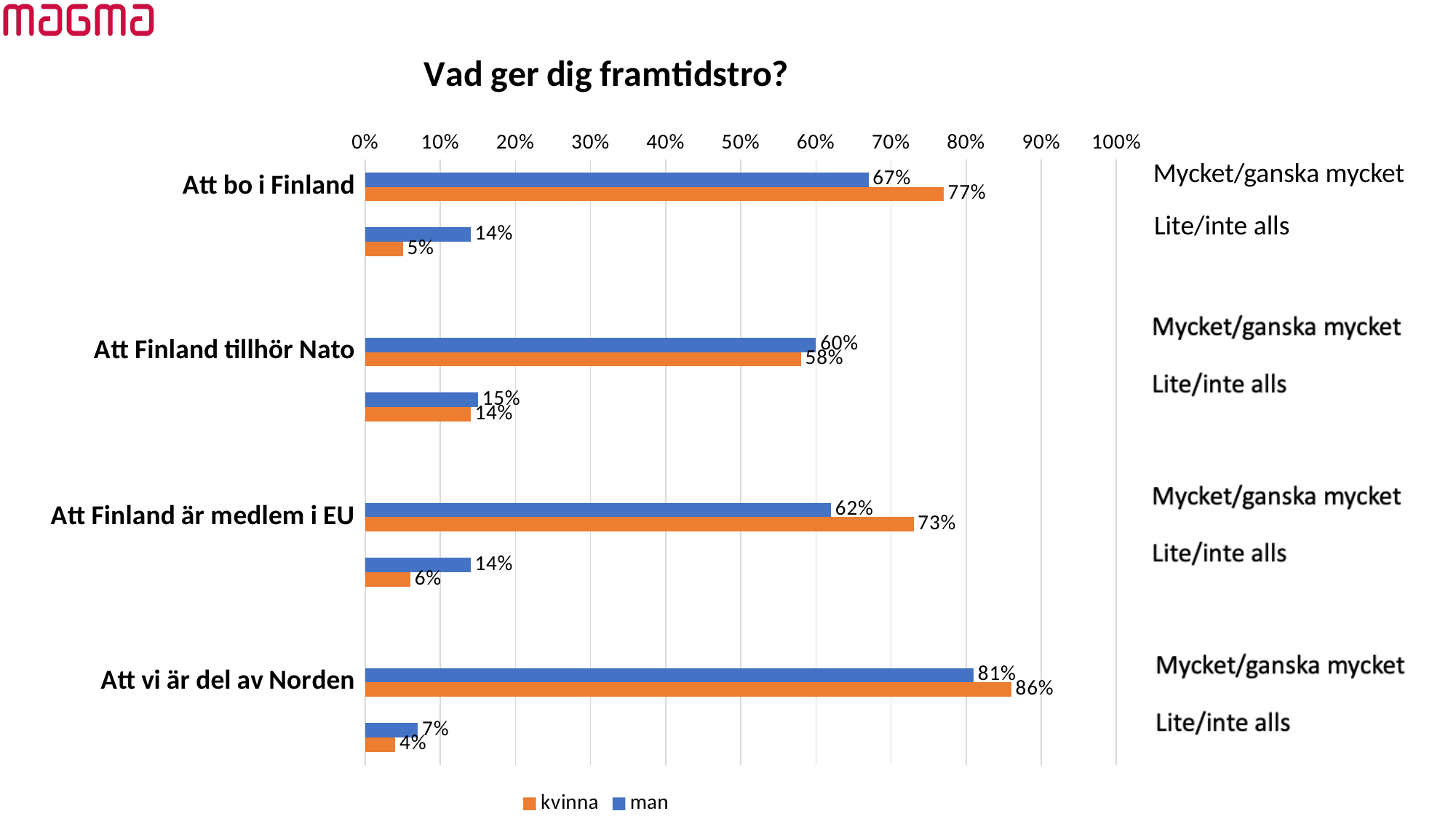
How many series does the legend list? 2 What is the title of the chart? Vad ger dig framtidstro? For 'Att Finland tillhör Nato' (Mycket/ganska mycket), which is larger: the value for man or for kvinna? man What kind of chart is shown on the slide? Bar chart How many main categories are shown on the vertical axis? 4 Which colour represents kvinna in the chart? Orange What is the value for man for 'Att Finland tillhör Nato' (Lite/inte alls)? 15% What is the value for kvinna for 'Att vi är del av Norden' (Mycket/ganska mycket)? 86% What is the difference between the kvinna and man values for 'Att Finland är medlem i EU' (Mycket/ganska mycket)? 11% What is the value for kvinna for 'Att bo i Finland' (Mycket/ganska mycket)? 77% Which category has the highest Mycket/ganska mycket value for man? Att vi är del av Norden Which category has the lowest Lite/inte alls value for kvinna? Att vi är del av Norden